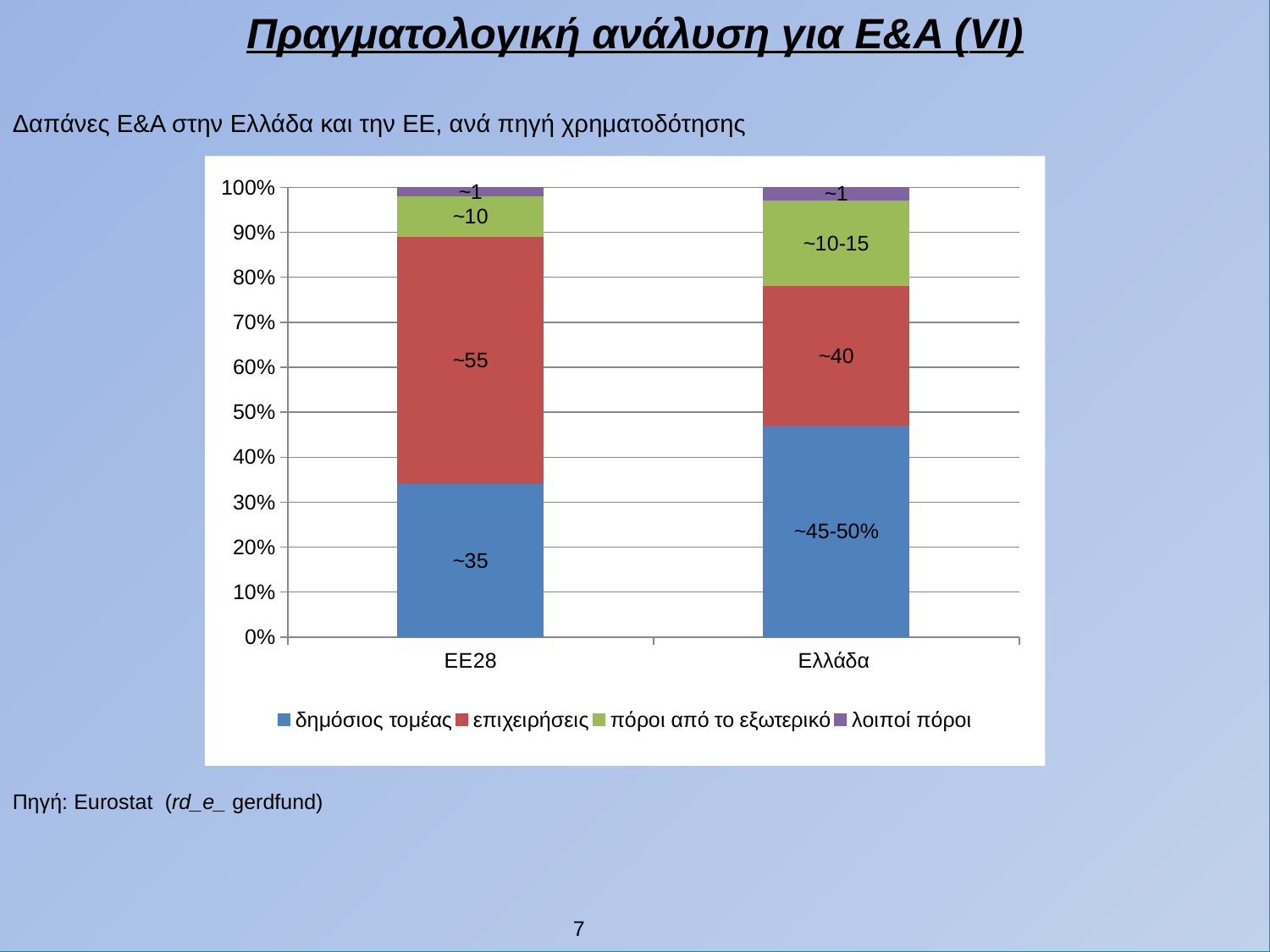
Which bar has the larger επιχειρήσεις segment, EE28 or Ελλάδα? EE28 Which bar has the larger πόροι από το εξωτερικό segment, EE28 or Ελλάδα? Ελλάδα What data label is printed on the δημόσιος τομέας segment of the EE28 bar? ~35 What data label is printed on the δημόσιος τομέας segment of the Ελλάδα bar? ~45-50% Which colour represents επιχειρήσεις in the chart legend? red What kind of chart is shown on the slide? stacked bar chart How many categories are shown on the x axis of the chart? 2 Is the top of the δημόσιος τομέας segment in the EE28 bar greater or less than 40%? less Which bar has the larger δημόσιος τομέας segment, EE28 or Ελλάδα? Ελλάδα Is the top of the δημόσιος τομέας segment in the Ελλάδα bar greater or less than 40%? greater What data label is printed on the επιχειρήσεις segment of the Ελλάδα bar? ~40 How many series does the chart legend list? 4